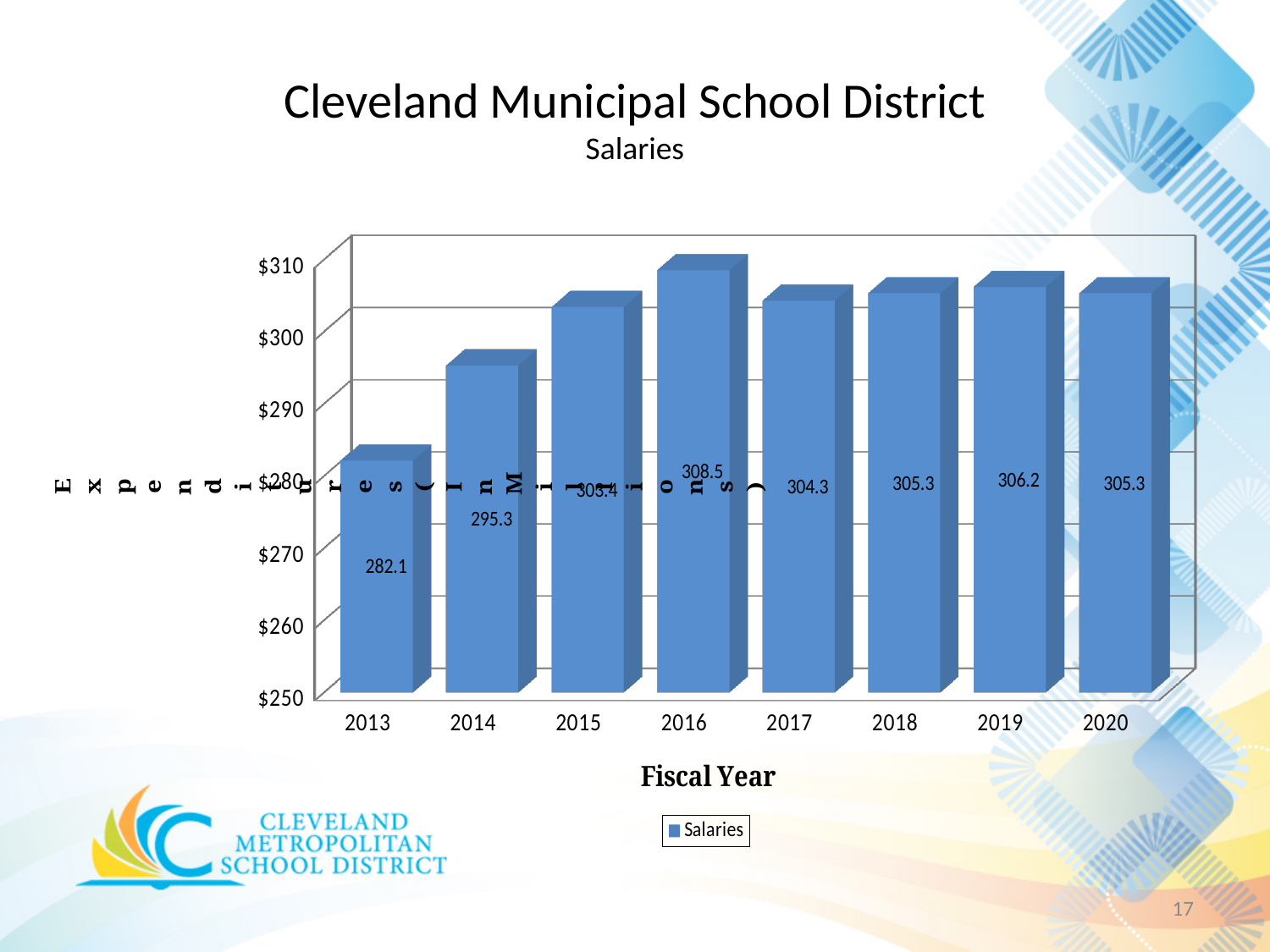
What is the title of the x axis? Fiscal Year What is the salaries value for fiscal year 2013? 282.1 How many fiscal years are shown on the x axis? 8 What is the difference between the salaries values for 2016 and 2017? 4.2 Which fiscal year has the highest salaries value? 2016 What kind of chart is shown on the slide? bar chart Which fiscal year has the lowest salaries value? 2013 What is the difference between the salaries values for 2014 and 2013? 13.2 What is the salaries value for fiscal year 2019? 306.2 What is the salaries value for fiscal year 2016? 308.5 Which fiscal year has a larger salaries value, 2015 or 2019? 2019 Is the salaries value for 2014 greater or less than $300? less